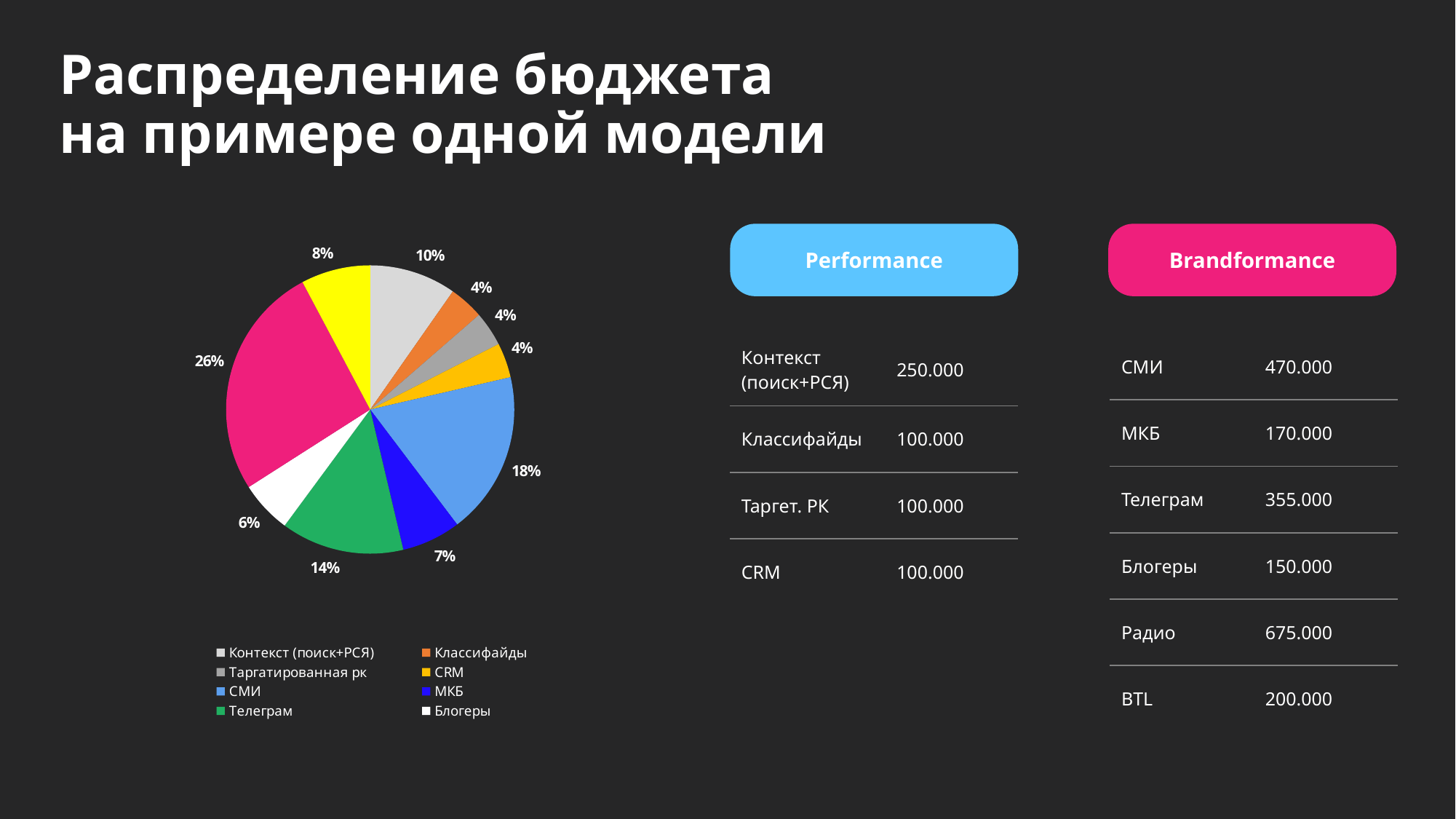
What share of the budget does СМИ take in the pie chart? 18% What is the percentage of the largest slice in the pie chart? 26% What percentage is shown for МКБ in the pie chart? 7% What type of chart is shown on the slide? pie chart Which has the larger share in the pie chart, СМИ or Телеграм? СМИ What percentage is shown for Блогеры in the pie chart? 6% What is the percentage of the smallest slices in the pie chart? 4% What percentage is shown for Контекст (поиск+РСЯ) in the pie chart? 10% How many slices does the pie chart have? 10 What percentage is shown for Телеграм in the pie chart? 14% By how many percentage points does the СМИ share exceed the Телеграм share? 4 How many entries does the pie chart's legend list? 8